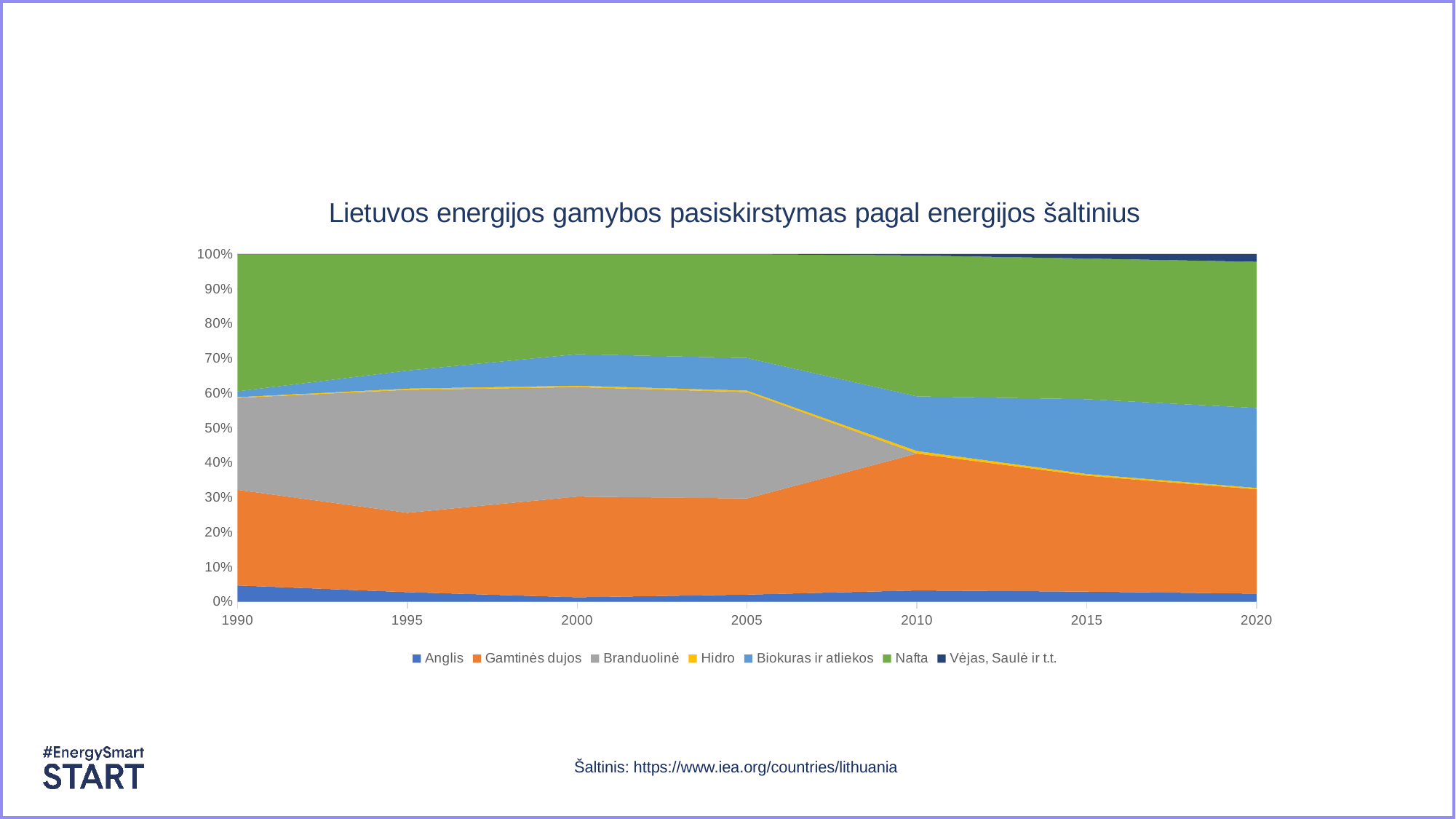
Is the share of Anglis in 2020 greater or less than 10%? less What kind of chart is shown on the slide? Stacked area chart Which series is shown in green in the legend? Nafta Which energy source has the largest share in 1990? Nafta How many years are labelled on the x axis? 7 Does the share of Branduolinė rise or fall between 2005 and 2010? fall Is the share of Nafta in 1990 greater or less than 30%? greater What is the title of the chart? Lietuvos energijos gamybos pasiskirstymas pagal energijos šaltinius Is the share of Biokuras ir atliekos in 2020 greater or less than 10%? greater Which energy source has the largest share in 2020? Nafta How many series does the legend list? 7 Is the share of Biokuras ir atliekos larger in 1990 or in 2020? 2020